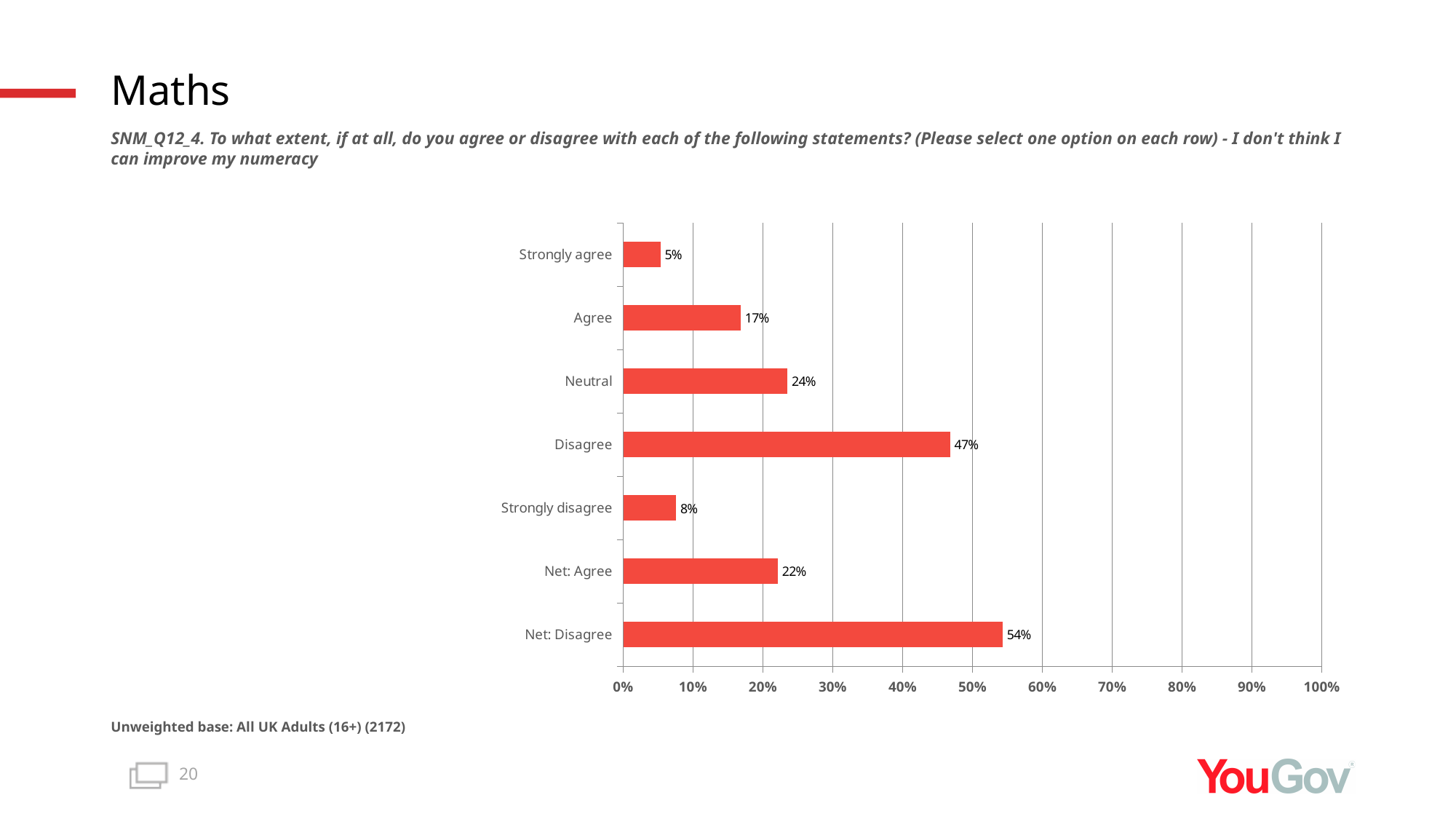
Which category has the highest value? Net: Disagree Is the value for 'Disagree' greater or less than 40%? greater Which category has the lowest value? Strongly agree How many categories are shown on the chart? 7 What is the difference between 'Neutral' and 'Agree'? 7% Which is larger, 'Strongly disagree' or 'Strongly agree'? Strongly disagree What percentage of respondents selected 'Disagree'? 47% What kind of chart is shown on the slide? Bar chart What is the value shown for 'Net: Agree'? 22% What is the difference between 'Net: Disagree' and 'Net: Agree'? 32% What is the unweighted base stated below the chart? All UK Adults (16+) (2172) What is the value shown for 'Strongly agree'? 5%